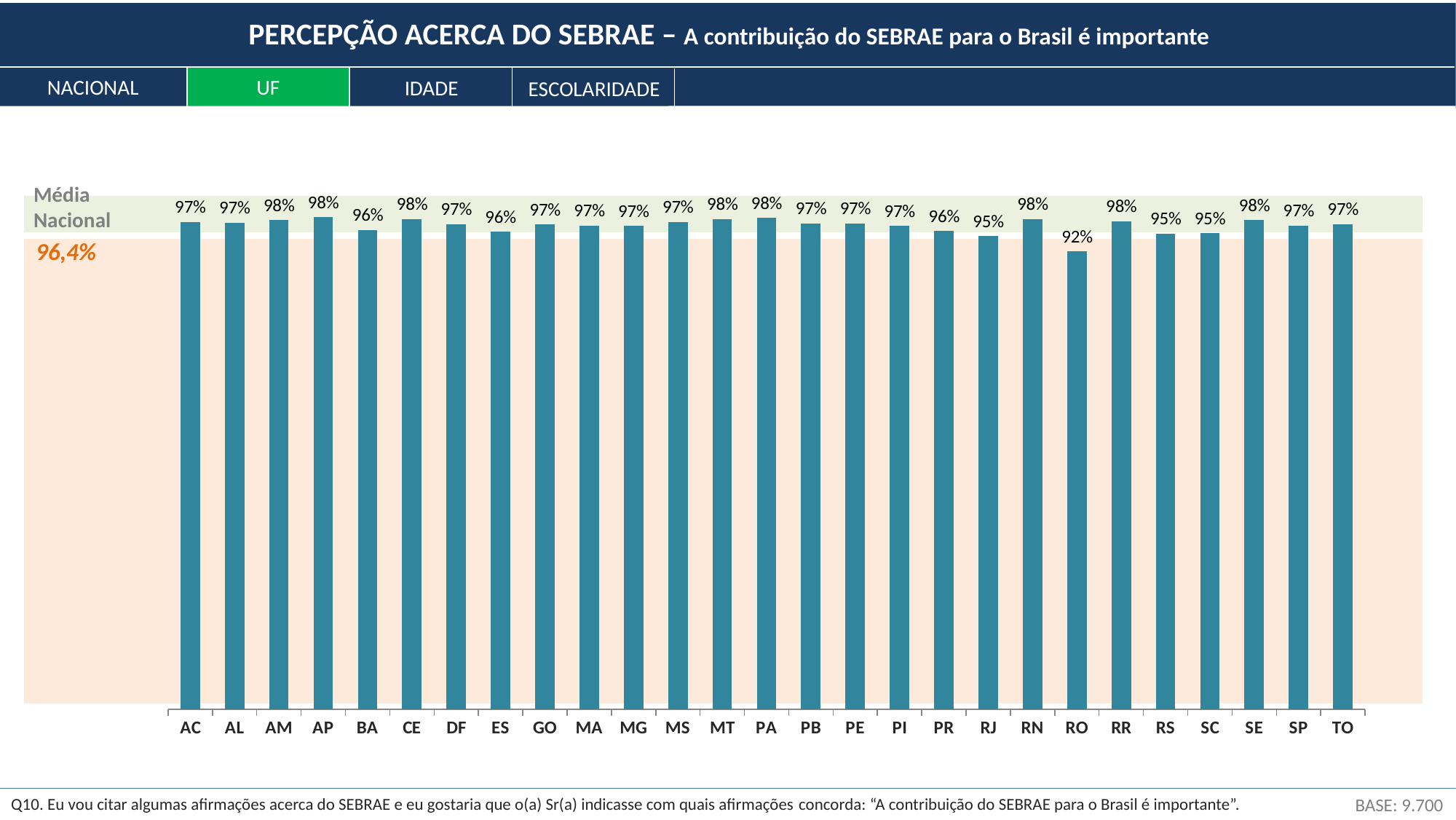
What is the value for RO? 92% What is the value for RJ? 95% What is the national average (Média Nacional) shown on the chart? 96,4% What is the difference between the values for AP and RS? 3 percentage points What is the difference between the values for AC and RO? 5 percentage points Which state (UF) has the lowest value? RO What is the value for AM? 98% Which has a larger value, CE or PR? CE Which has a larger value, RJ or RO? RJ How many states (UF) are shown on the x axis? 27 What kind of chart is shown on the slide? Bar chart What is the value for BA? 96%